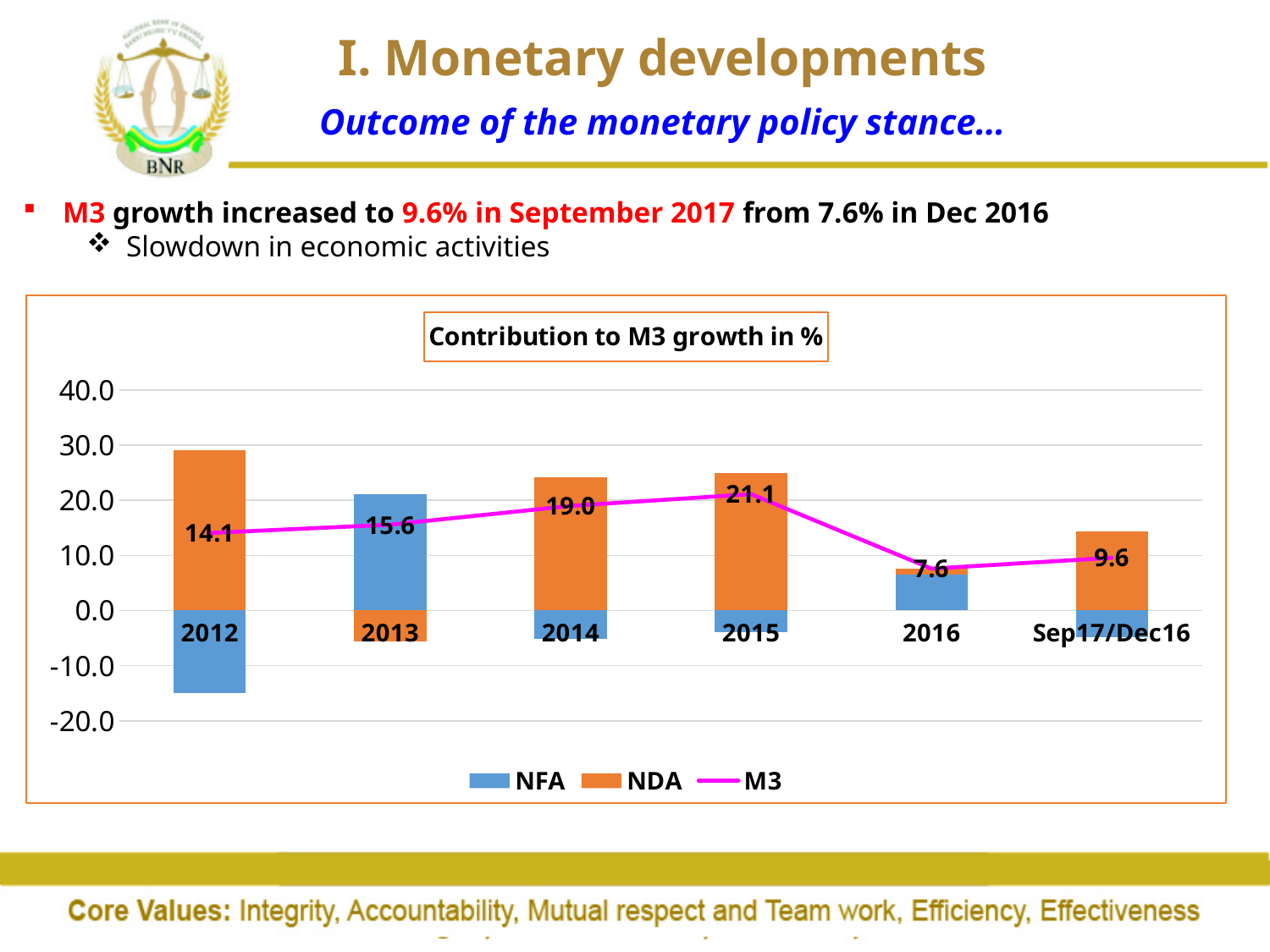
How many series does the legend list? 3 Which has a higher M3 value, 2013 or 2014? 2014 Is the NFA value for 2012 greater or less than -10.0? less How many categories are shown on the x axis? 6 What is the M3 value for 2012? 14.1 What is the M3 value for Sep17/Dec16? 9.6 In which category is the M3 line lowest? 2016 Is the NDA value for 2012 greater or less than 20.0? greater In which category is the M3 line highest? 2015 What is the difference between the M3 values for 2015 and 2016? 13.5 What is the title of the chart? Contribution to M3 growth in % What is the M3 value for 2015? 21.1